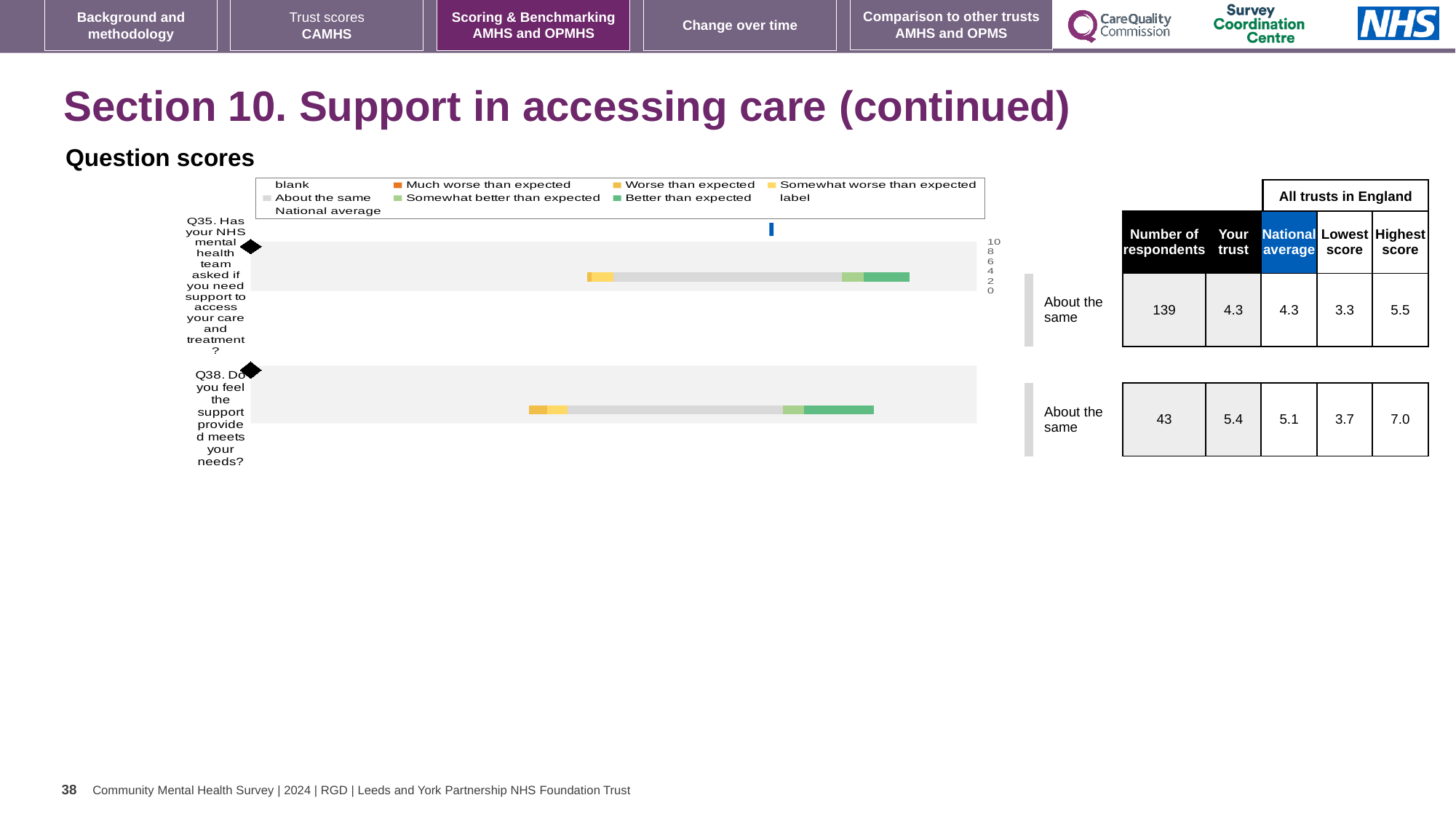
What is the difference between the highest and lowest score across all trusts in England for Q38? 3.3 What is the national average score for Q38? 5.1 How many questions (categories) are plotted in the question scores chart? 2 What is the highest score among all trusts in England for Q38? 7.0 What benchmark category is shown for both Q35 and Q38? About the same What kind of chart is used to show the question scores on this slide? bar chart What is the 'Your trust' score for Q38 (Do you feel the support provided meets your needs?)? 5.4 How many respondents answered Q35? 139 How many entries does the legend of the question scores chart list? 9 Which question has the higher 'Your trust' score, Q35 or Q38? Q38 Which question has the lower number of respondents, Q35 or Q38? Q38 What is the 'Your trust' score for Q35 (Has your NHS mental health team asked if you need support to access your care and treatment?)? 4.3